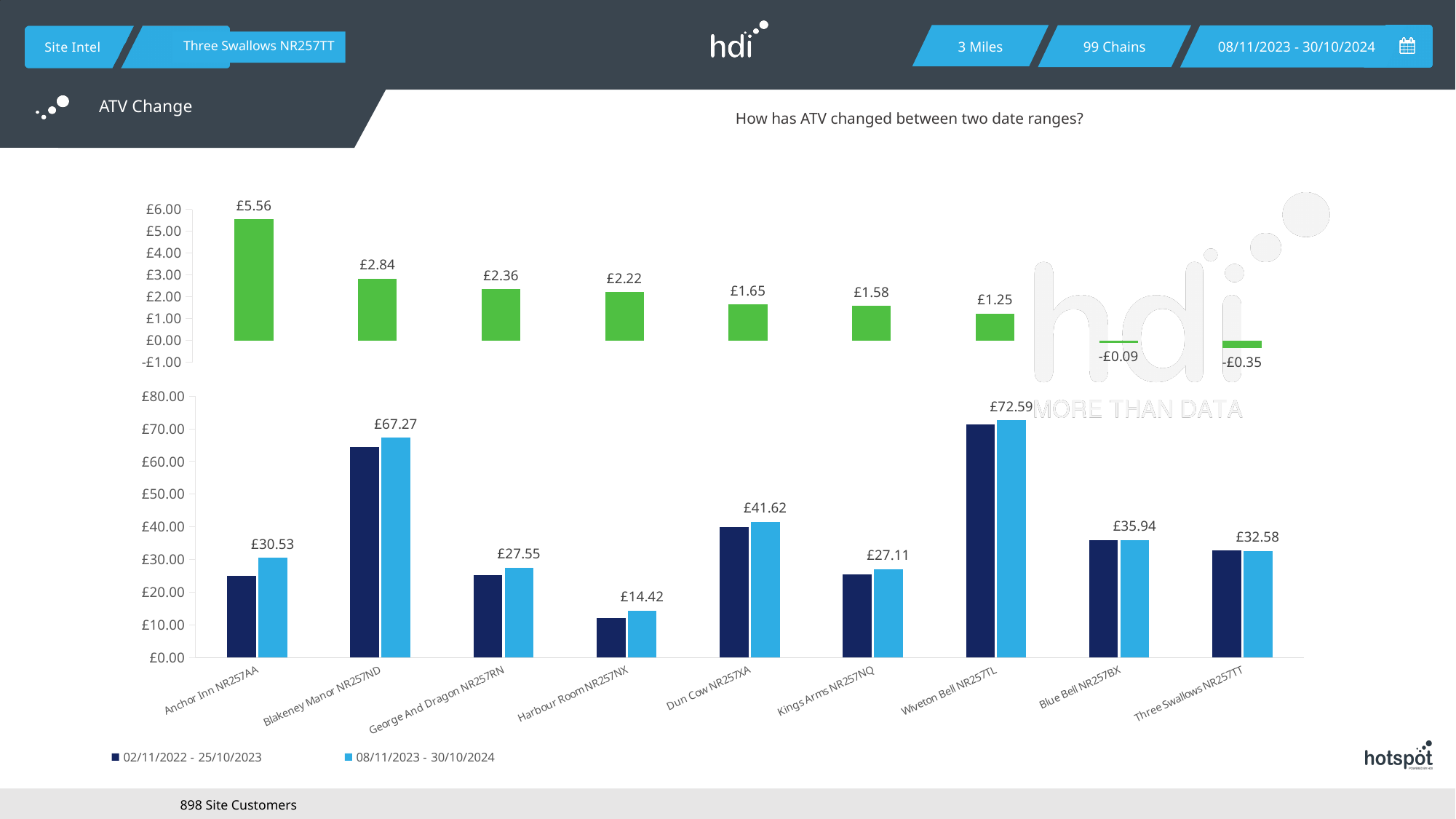
In the bottom chart, which site has the highest value in the 08/11/2023 - 30/10/2024 period? Wiveton Bell NR257TL In the bottom chart, what is the value for Harbour Room NR257NX in the 08/11/2023 - 30/10/2024 period? £14.42 In the bottom chart, what is the value for Blakeney Manor NR257ND in the 08/11/2023 - 30/10/2024 period? £67.27 In the top chart, what is the ATV change for Anchor Inn NR257AA? £5.56 How many series does the legend of the bottom chart list? 2 In the bottom chart, is the 02/11/2022 - 25/10/2023 value for Blakeney Manor NR257ND greater or less than £60.00? greater In the top chart, which site has the lowest ATV change? Three Swallows NR257TT In the top chart, what is the difference between the ATV change for Anchor Inn NR257AA and Blakeney Manor NR257ND? £2.72 What kind of chart is the bottom chart? bar chart In the top chart, what is the ATV change for Three Swallows NR257TT? -£0.35 In the bottom chart, which is larger for the 08/11/2023 - 30/10/2024 period: Dun Cow NR257XA or Blue Bell NR257BX? Dun Cow NR257XA In the top chart, how many sites are plotted? 9